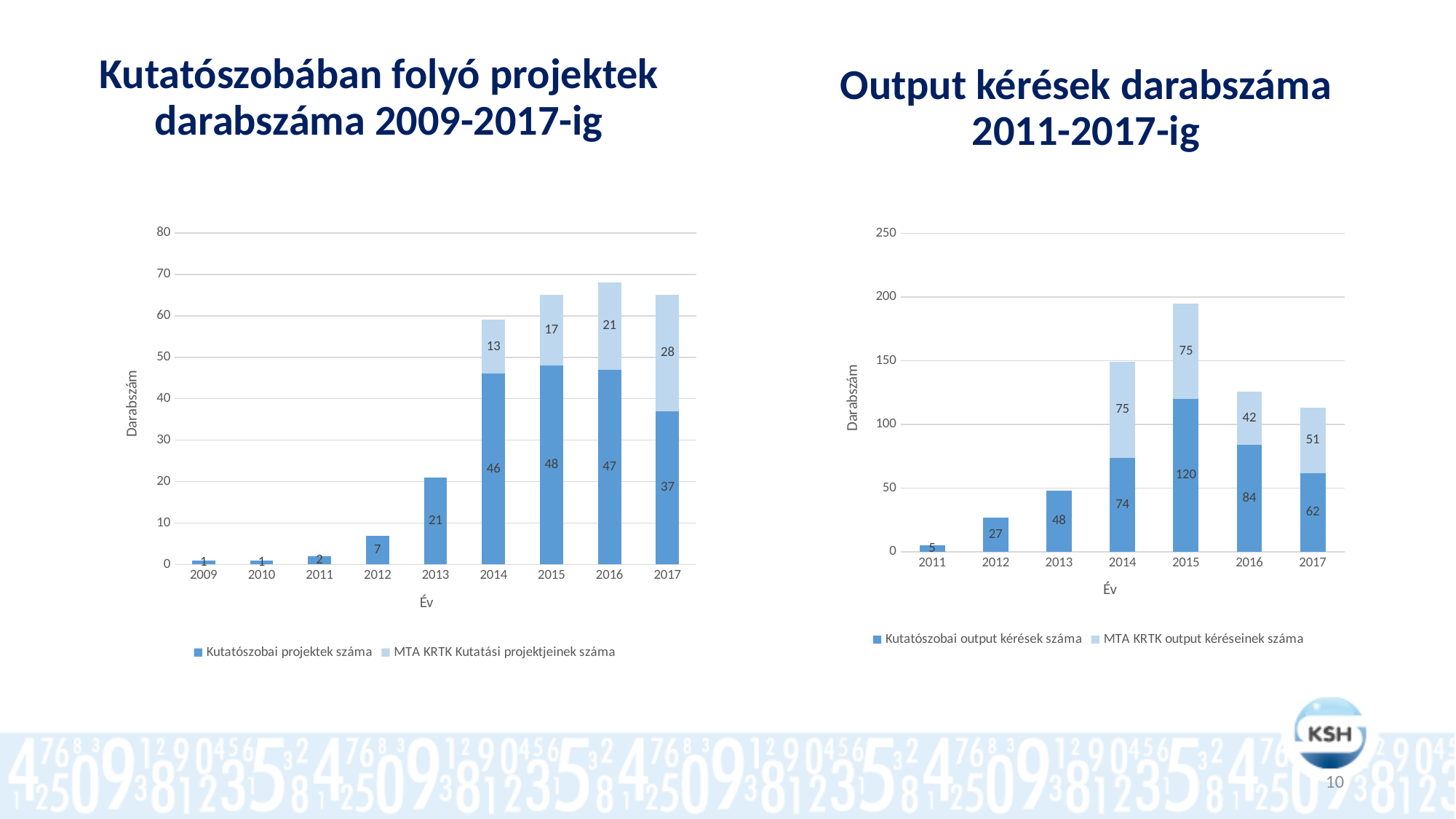
In the right chart (Output kérések darabszáma 2011-2017-ig), which year has the lowest value of Kutatószobai output kérések száma? 2011 In the left chart (Kutatószobában folyó projektek darabszáma 2009-2017-ig), which year has the highest value of Kutatószobai projektek száma? 2015 In the left chart (Kutatószobában folyó projektek darabszáma 2009-2017-ig), what is the total of the stacked bar for 2016? 68 How many series does the legend of the right chart (Output kérések darabszáma 2011-2017-ig) list? 2 In the left chart (Kutatószobában folyó projektek darabszáma 2009-2017-ig), what is the value of Kutatószobai projektek száma for 2015? 48 In the right chart (Output kérések darabszáma 2011-2017-ig), what is the total of the stacked bar for 2017? 113 In the right chart (Output kérések darabszáma 2011-2017-ig), what is the value of Kutatószobai output kérések száma for 2015? 120 In the left chart (Kutatószobában folyó projektek darabszáma 2009-2017-ig), what is the value of MTA KRTK Kutatási projektjeinek száma for 2017? 28 In the left chart (Kutatószobában folyó projektek darabszáma 2009-2017-ig), how many years are shown on the x axis? 9 In the right chart (Output kérések darabszáma 2011-2017-ig), is the Kutatószobai output kérések száma value for 2016 larger or smaller than the value for 2017? larger In the right chart (Output kérések darabszáma 2011-2017-ig), what is the value of MTA KRTK output kéréseinek száma for 2016? 42 In the left chart (Kutatószobában folyó projektek darabszáma 2009-2017-ig), what is the difference between the Kutatószobai projektek száma values for 2014 and 2013? 25